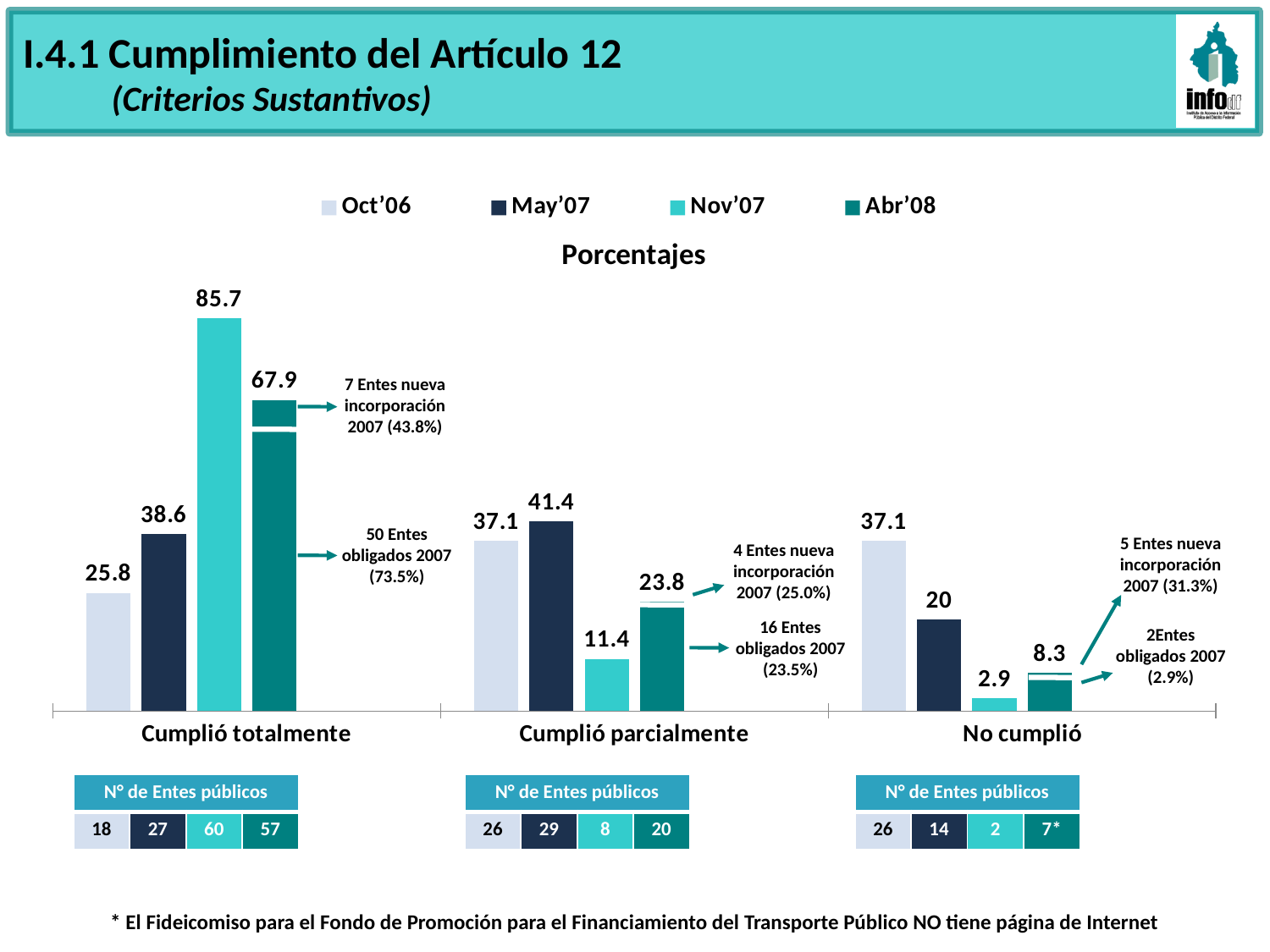
What is the value for Nov'07 in the Cumplió totalmente category? 85.7 What kind of chart is shown on the slide? Bar chart Which series has the highest value in the Cumplió totalmente category? Nov'07 What is the value for Abr'08 in the Cumplió parcialmente category? 23.8 What is the title of the chart? Porcentajes What is the value for May'07 in the No cumplió category? 20 Which series has the lowest value in the No cumplió category? Nov'07 How many categories are shown on the x axis of the chart? 3 How many series does the legend list? 4 What is the difference between the Oct'06 and Nov'07 values in the No cumplió category? 34.2 Which is larger in the Cumplió parcialmente category: the Oct'06 value or the May'07 value? May'07 What is the difference between the Nov'07 and Abr'08 values in the Cumplió totalmente category? 17.8